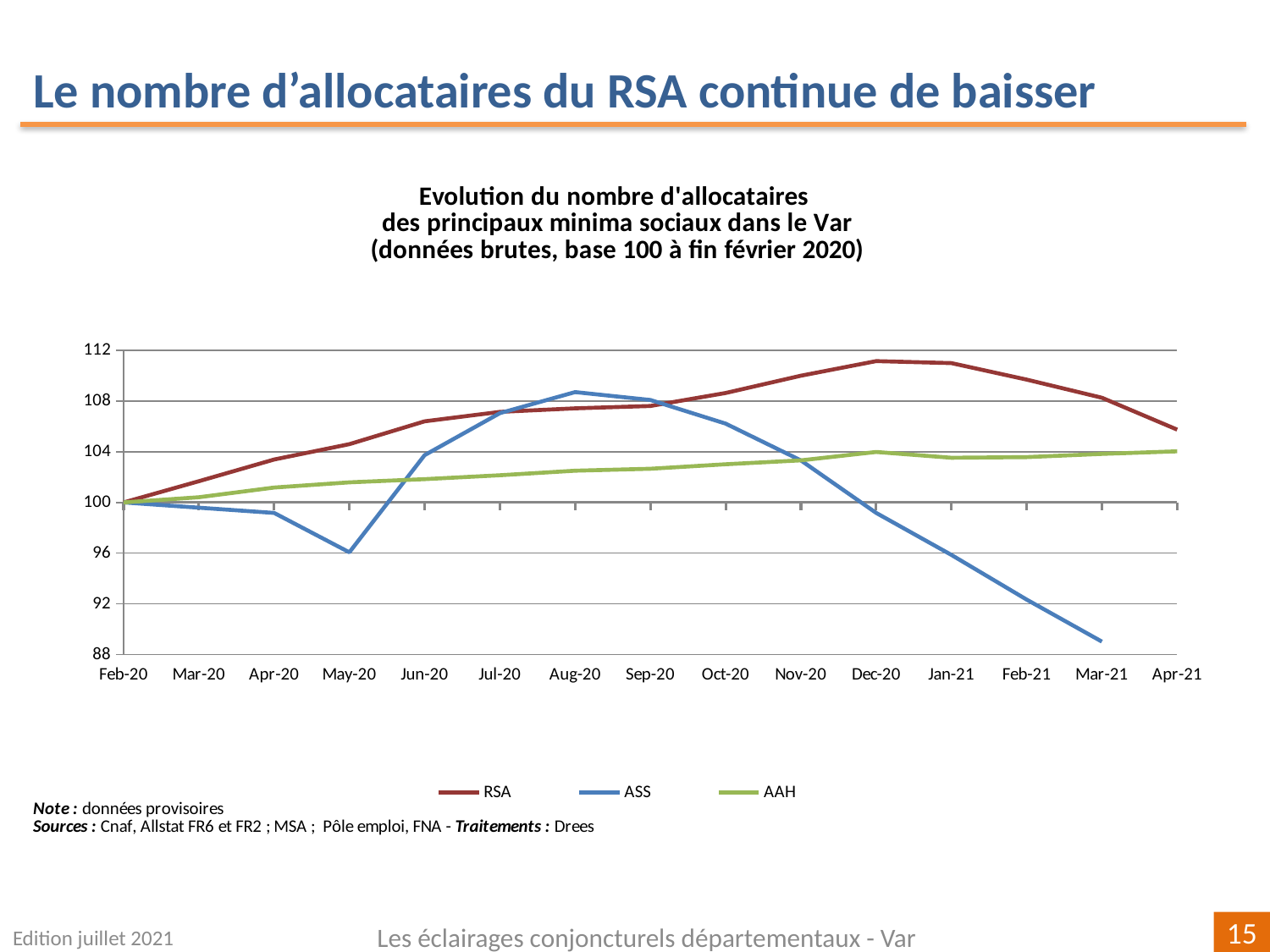
Which series has the lowest value at Mar-21? ASS What is the value of the RSA series at Feb-20? 100 At Dec-20, which is larger, the RSA value or the ASS value? RSA Which colour is used for the ASS series? blue Is the value for ASS at Mar-21 greater or less than 92? less Is the value for RSA at Dec-20 greater or less than 108? greater What kind of chart is shown on the slide? line chart Does the ASS series rise or fall between Dec-20 and Mar-21? fall How many series does the legend list? 3 Which series has the highest value at Apr-21? RSA How many months are shown on the x axis? 15 Is the value for AAH at Jun-20 greater or less than 104? less